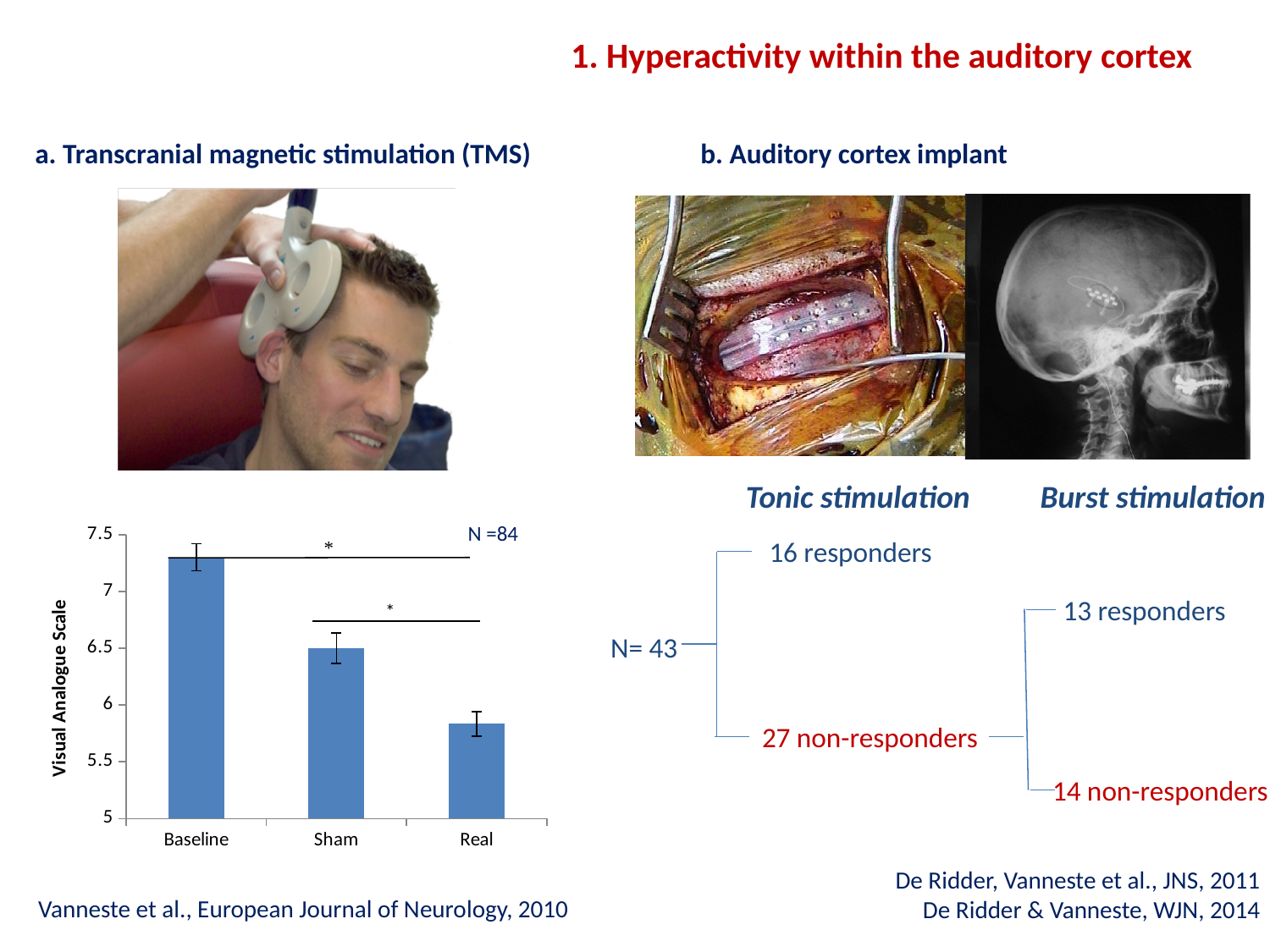
How many categories are shown on the x axis of the bar chart? 3 What is the label on the y axis of the bar chart? Visual Analogue Scale Is the value for Baseline greater or less than 7? greater Which category has the lowest value in the bar chart? Real Which category has the highest value in the bar chart? Baseline Is the value for Sham greater or less than 6? greater Do the values in the bar chart rise or fall from Baseline to Real? fall What kind of chart is shown on the slide? bar chart Is the value for Sham greater or less than 7? less What sample size (N) is annotated on the bar chart? N =84 Which is larger in the bar chart, the value for Sham or the value for Real? Sham